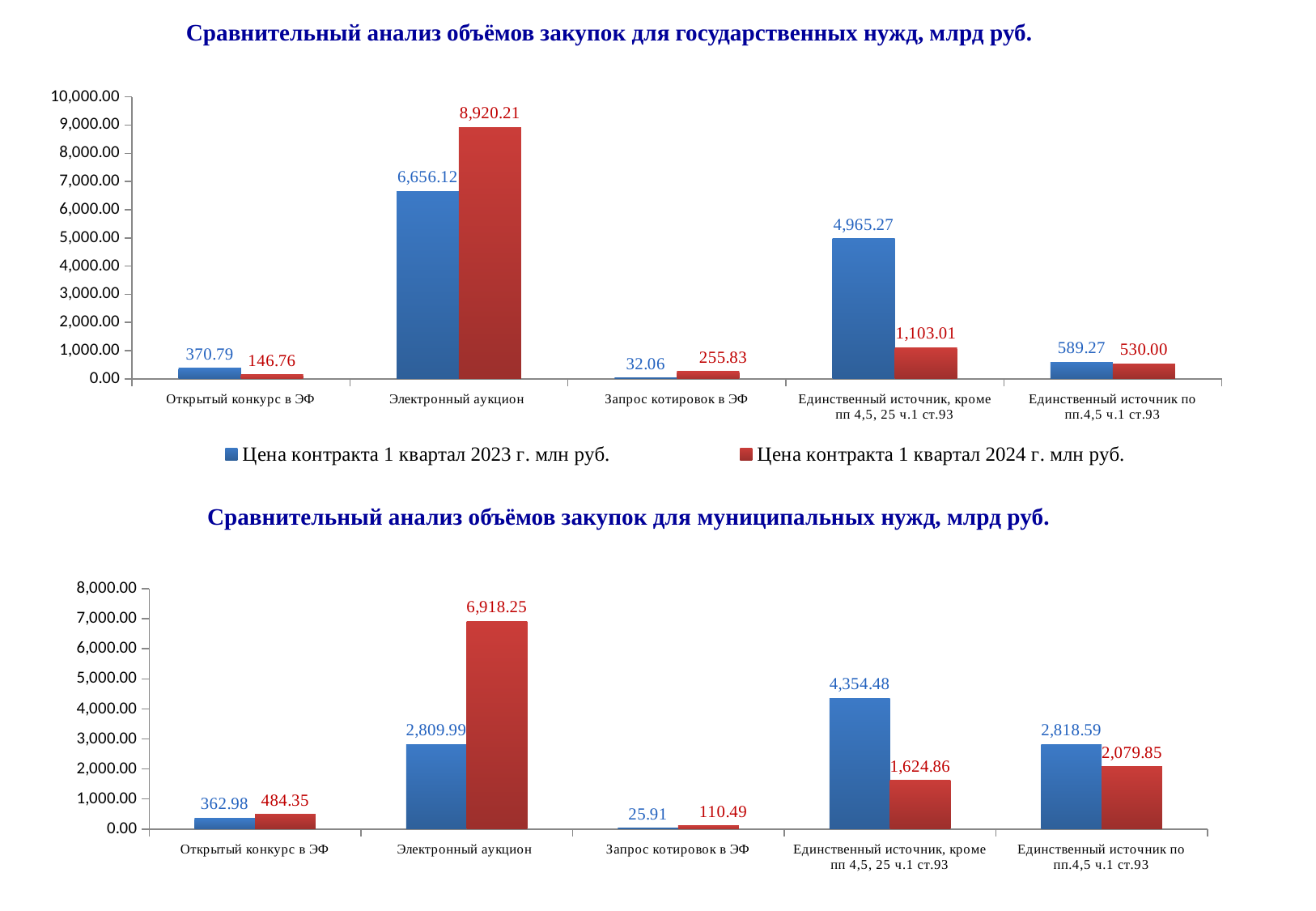
In the top chart (государственных нужд), what is the value for Единственный источник, кроме пп 4,5, 25 ч.1 ст.93 in the series Цена контракта 1 квартал 2023 г. млн руб.? 4,965.27 In the bottom chart (муниципальных нужд), what is the difference between the blue and red bars for Единственный источник, кроме пп 4,5, 25 ч.1 ст.93? 2,729.62 In the top chart (государственных нужд), what is the value for Электронный аукцион in the series Цена контракта 1 квартал 2024 г. млн руб.? 8,920.21 In the top chart (государственных нужд), which category has the highest value in the series Цена контракта 1 квартал 2023 г. млн руб.? Электронный аукцион What type of chart is the bottom chart (муниципальных нужд)? Bar chart How many series does the legend of the top chart (государственных нужд) list? 2 In the bottom chart (муниципальных нужд), what is the red bar value for Единственный источник по пп.4,5 ч.1 ст.93? 2,079.85 In the bottom chart (муниципальных нужд), which is larger for Открытый конкурс в ЭФ: the blue bar or the red bar? The red bar (484.35) In the top chart (государственных нужд), what is the difference between the 2024 and 2023 values for Электронный аукцион? 2,264.09 In the bottom chart (муниципальных нужд), which category has the highest blue bar value? Единственный источник, кроме пп 4,5, 25 ч.1 ст.93 In the top chart (государственных нужд), which category has the lowest value in the series Цена контракта 1 квартал 2024 г. млн руб.? Открытый конкурс в ЭФ How many categories are shown on the x axis of the bottom chart (муниципальных нужд)? 5